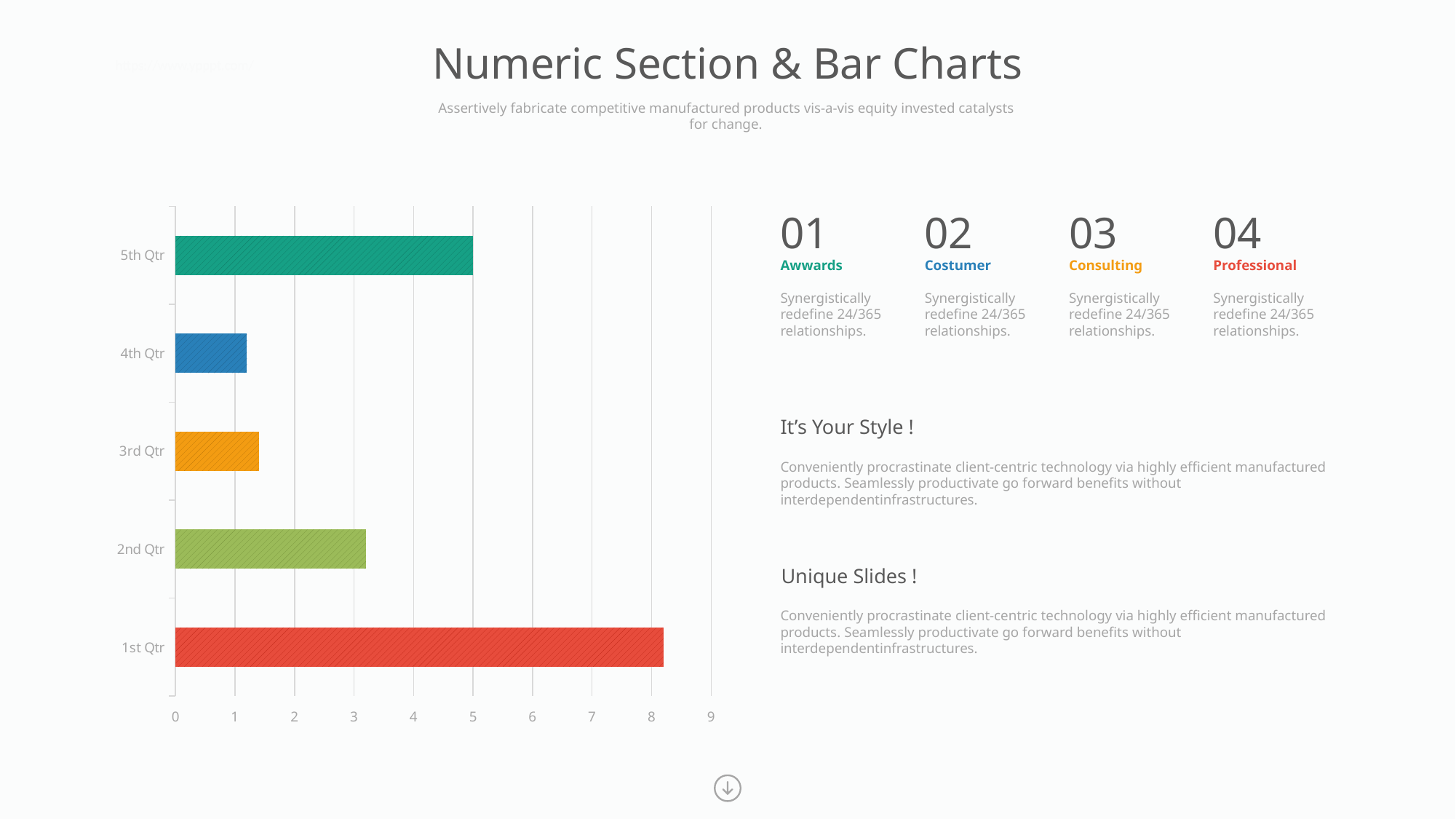
Is the value for 2nd Qtr greater or less than 3? greater Which is larger, the value for 2nd Qtr or the value for 3rd Qtr? 2nd Qtr What is the value for 5th Qtr in the bar chart? 5 Is the value for 3rd Qtr greater or less than 2? less Which category has the highest value in the bar chart? 1st Qtr What type of chart is shown on the slide? bar chart Is the value for 4th Qtr greater or less than 2? less How many categories are plotted in the bar chart? 5 What is the highest value shown on the horizontal axis of the bar chart? 9 What colour is the bar for 1st Qtr? red Which is larger, the value for 5th Qtr or the value for 4th Qtr? 5th Qtr